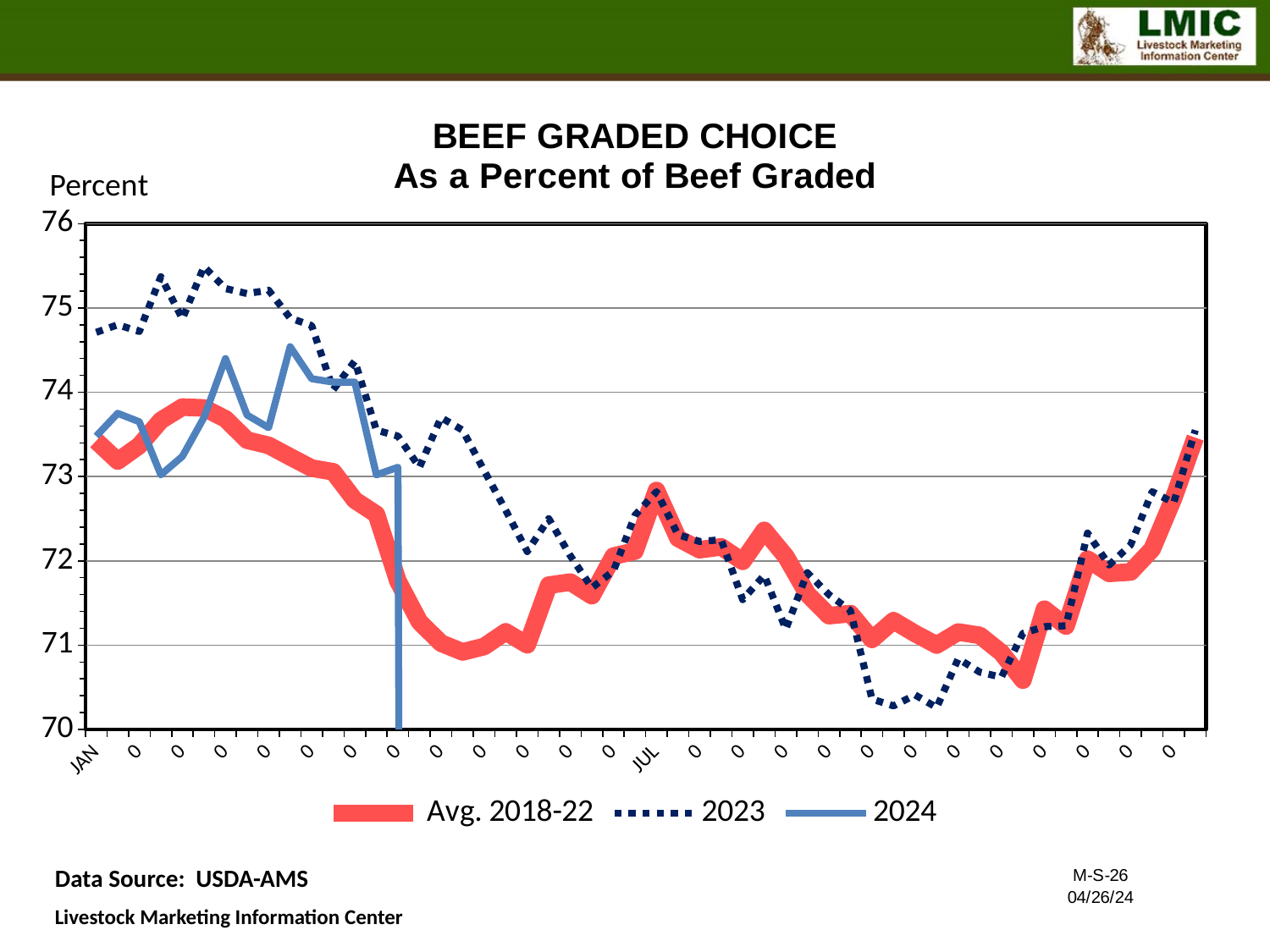
Does the 2023 series rise or fall from JAN to JUL? fall Is the value for the Avg. 2018-22 series in JUL greater or less than 72? greater Is the value for the 2023 series in JAN greater or less than 74? greater What is the title of the chart? BEEF GRADED CHOICE As a Percent of Beef Graded In JAN, which is higher: the 2023 series or the Avg. 2018-22 series? 2023 How many series does the legend list? 3 What kind of chart is shown on the slide? line chart Is the value for the Avg. 2018-22 series in JAN greater or less than 73? greater Which series reaches the highest value anywhere on the chart? 2023 What are the three series named in the legend? Avg. 2018-22, 2023, 2024